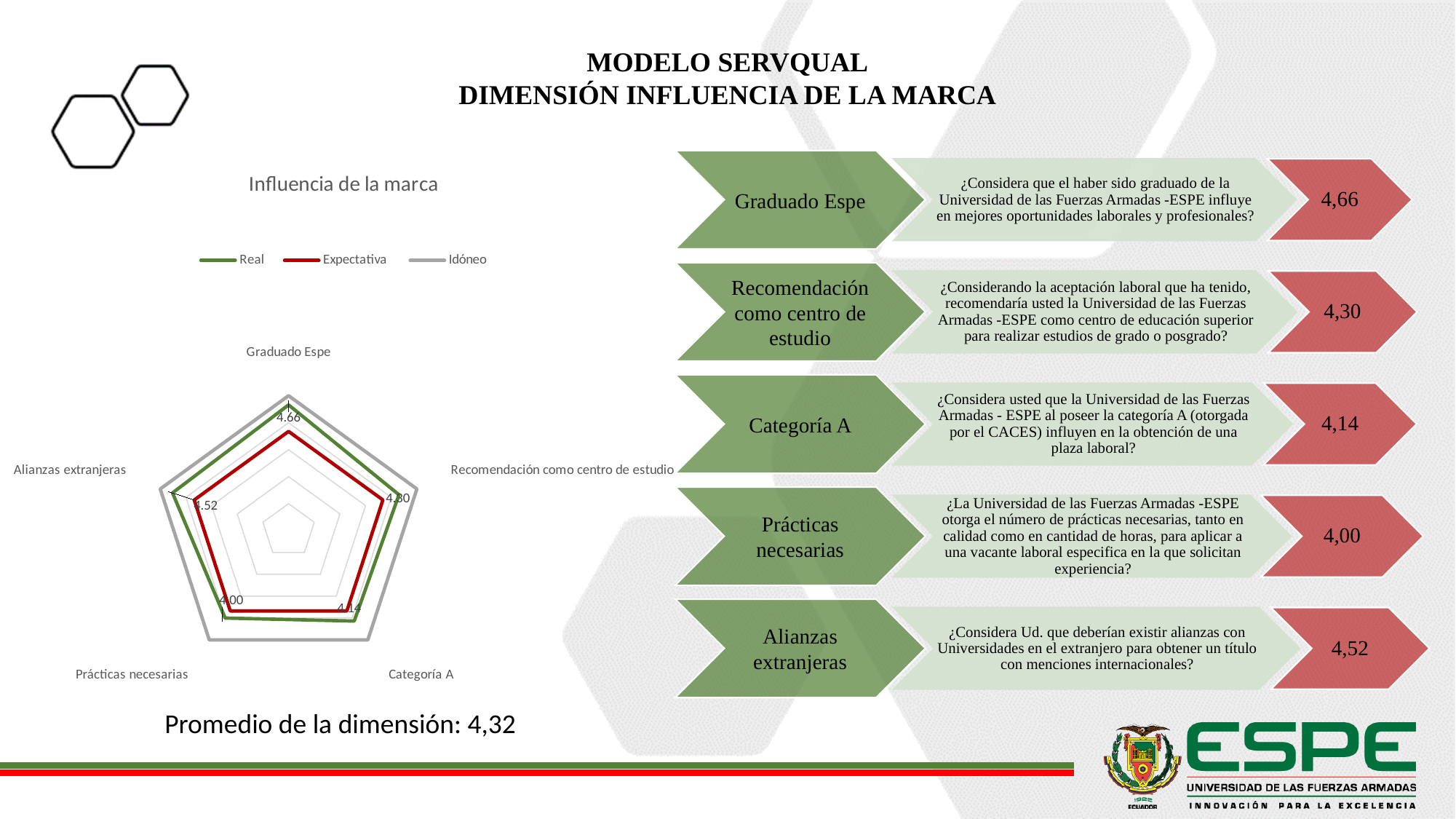
What is the Real value for Prácticas necesarias? 4,00 How many categories (axes) does the radar chart have? 5 Which category has the lowest Real value? Prácticas necesarias What is the title of the chart? Influencia de la marca What is the Real value for Graduado Espe? 4,66 How many series does the chart legend list? 3 Which series are listed in the chart legend? Real, Expectativa, Idóneo What is the Real value for Recomendación como centro de estudio? 4,30 What is the Real value for Alianzas extranjeras? 4,52 What kind of chart is shown on the slide? Radar chart What is the Real value for Categoría A? 4,14 Which category has the highest Real value? Graduado Espe